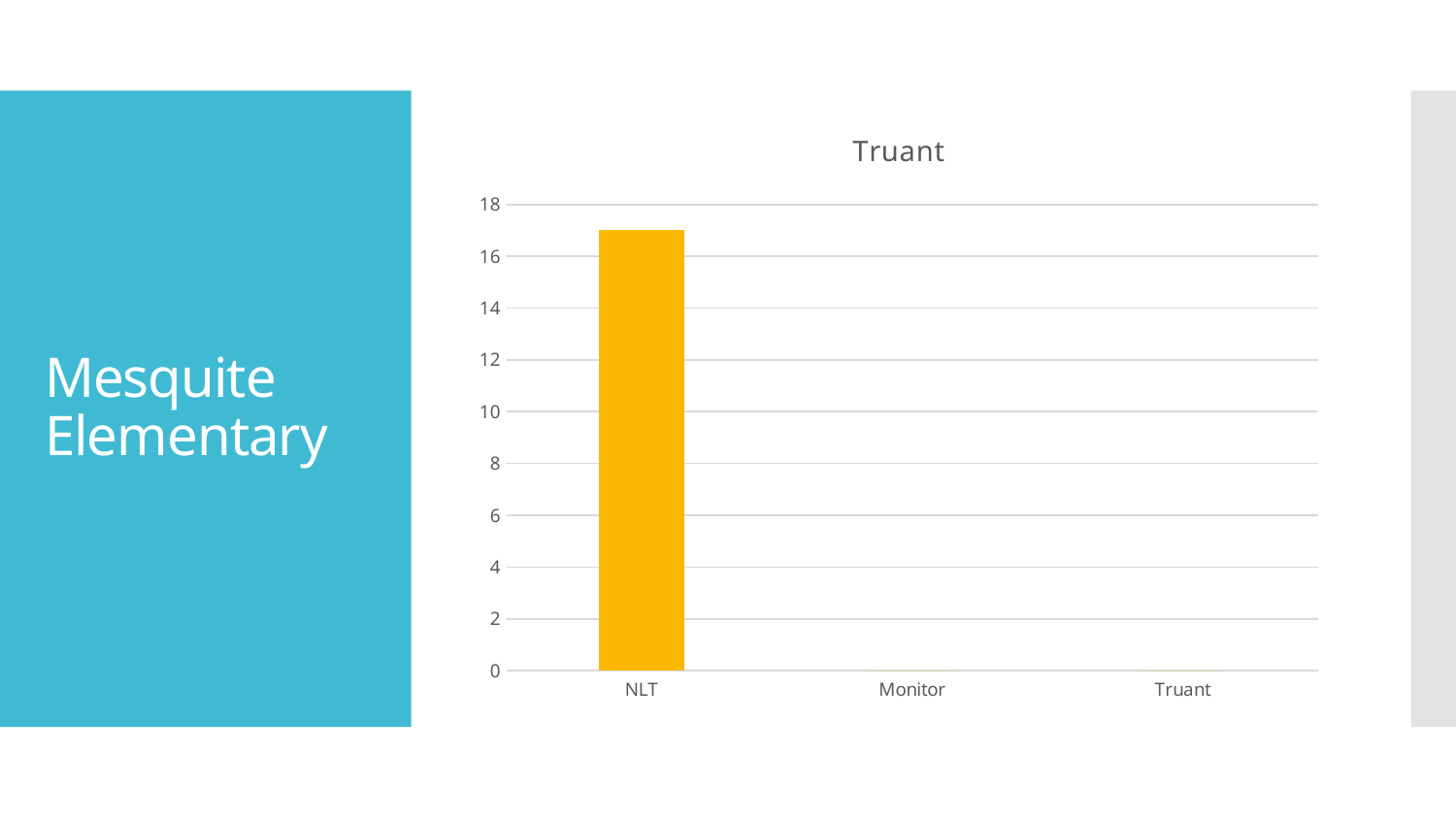
Is the value for Monitor greater or less than 2? less What is the highest value shown on the y axis of the chart? 18 Is the value for NLT greater or less than 16? greater How many categories are shown on the x axis of the chart? 3 Which category has the highest value in the chart? NLT Which is larger, the value for NLT or the value for Monitor? NLT Which is larger, the value for NLT or the value for Truant? NLT Is the value for NLT greater or less than 18? less Do the values rise or fall from NLT to Monitor along the x axis? fall What type of chart is shown on the slide? bar chart What is the title of the chart? Truant